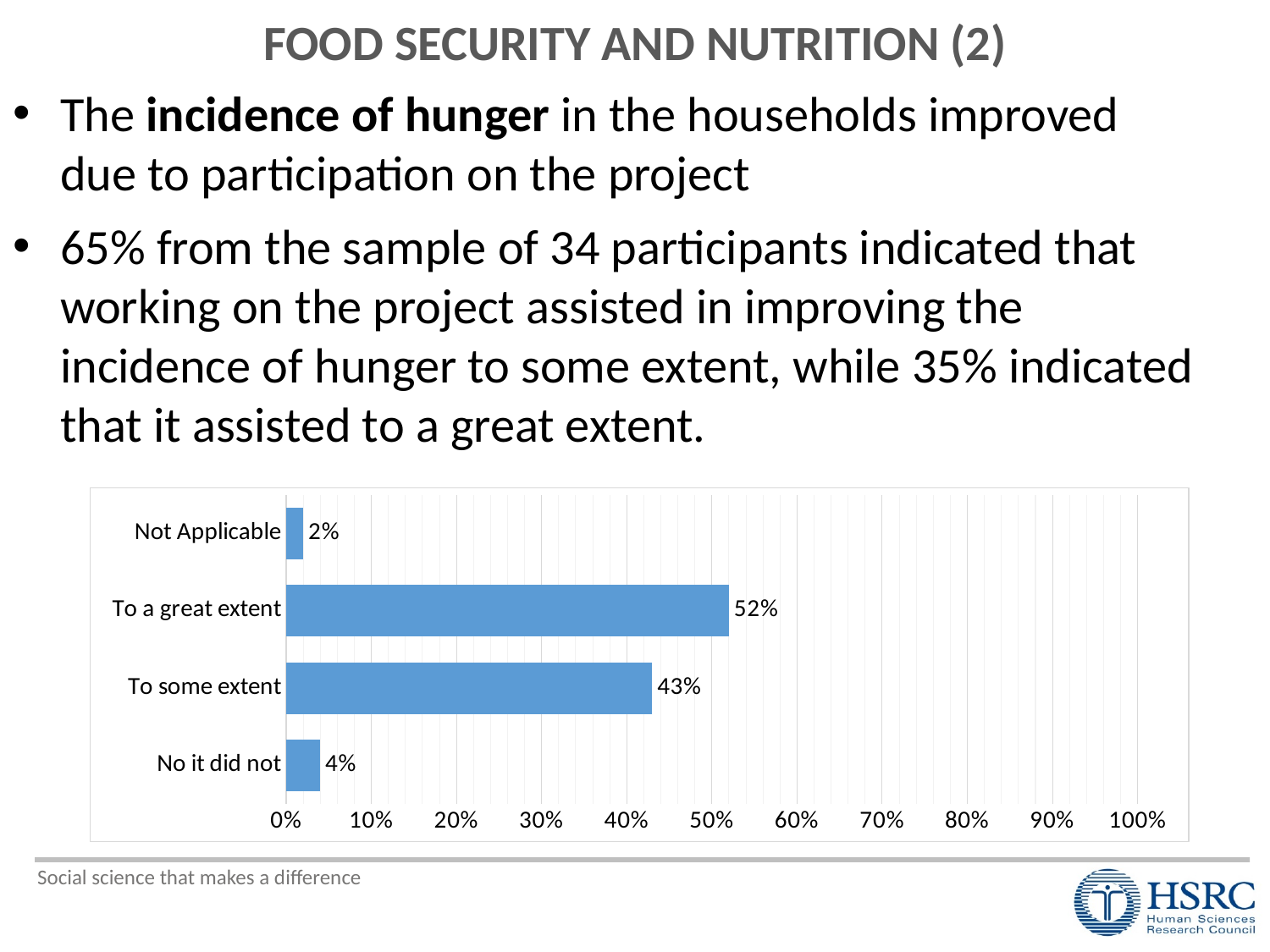
Which is larger, the value for "No it did not" or the value for "Not Applicable"? No it did not What is the value for "To some extent"? 43% Is the value for "To some extent" greater or less than 50%? less How many categories are shown in the chart? 4 What is the maximum value shown on the horizontal axis? 100% What is the value for "Not Applicable"? 2% Which category has the lowest value? Not Applicable What is the difference between the values for "To a great extent" and "To some extent"? 9% Which category has the highest value? To a great extent What is the value for "No it did not"? 4% What is the value for "To a great extent"? 52% What kind of chart is shown on the slide? Bar chart